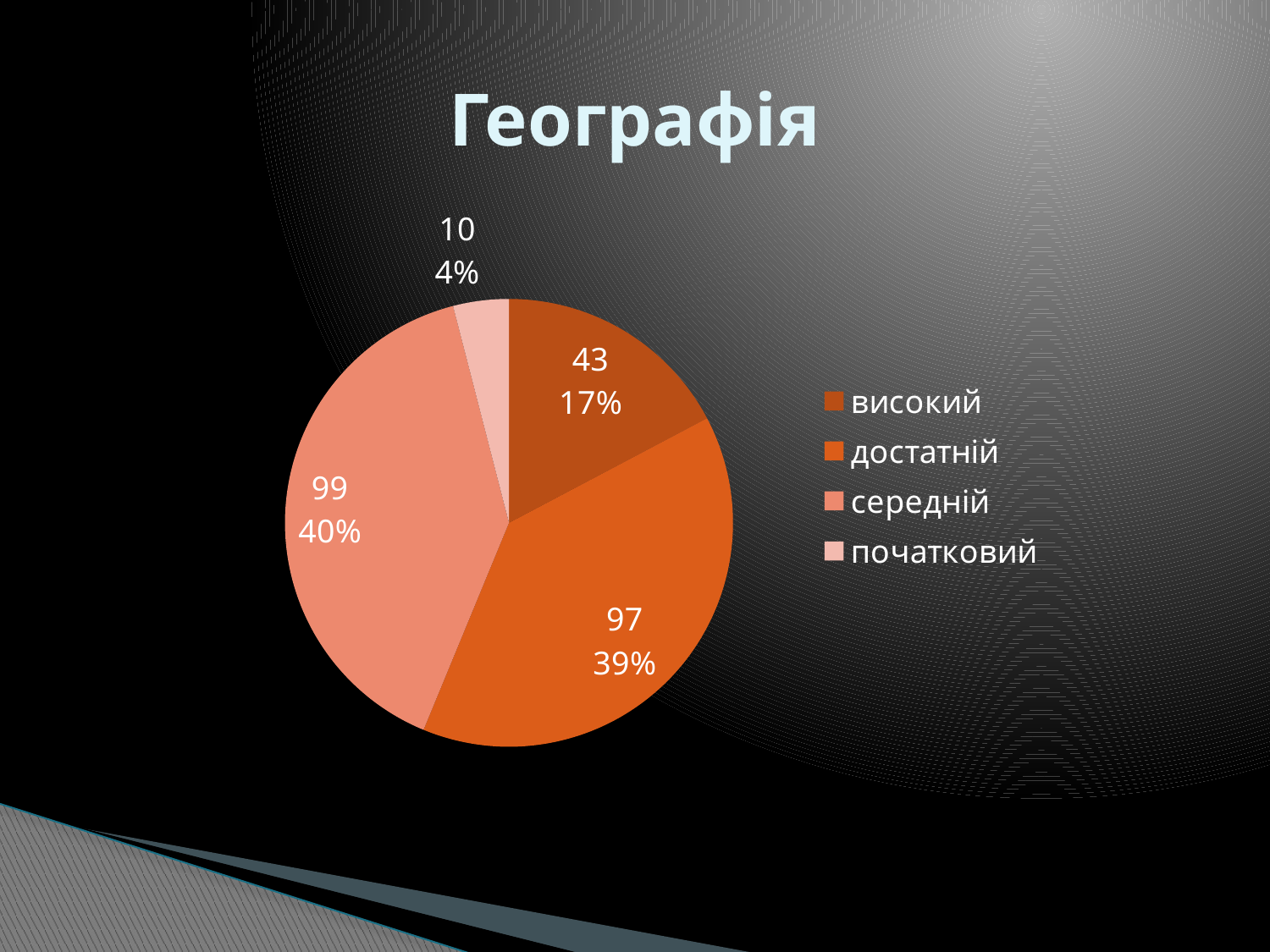
What is the value for високий? 43 What is the title of the chart? Географія How many entries does the legend list? 4 What is the value for середній? 99 What is the value for достатній? 97 How many slices does the pie chart have? 4 What is the difference between the values for достатній and високий? 54 Which is larger, the value for середній or the value for достатній? середній Which category has the smallest slice? початковий What kind of chart is shown on the slide? pie chart What is the value for початковий? 10 What share of the pie does високий represent? 17%